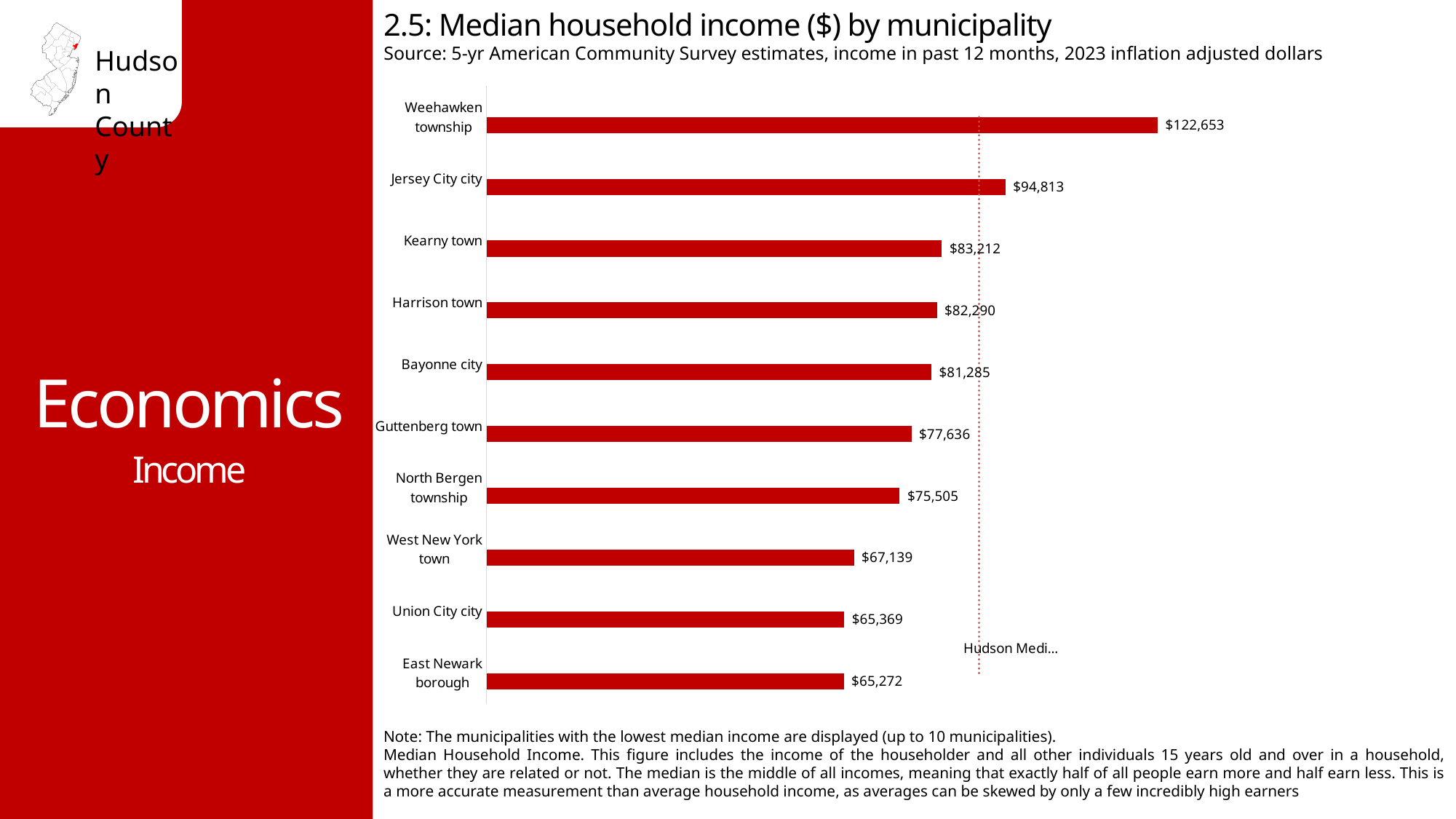
What is the difference in median household income between Union City city and East Newark borough? $97 Which has a higher median household income, Bayonne city or Guttenberg town? Bayonne city Which municipality has the lowest median household income on the chart? East Newark borough How many municipalities are shown on the chart? 10 Which municipality has the highest median household income on the chart? Weehawken township What is the median household income for East Newark borough? $65,272 What is the median household income for Weehawken township? $122,653 What is the median household income for Jersey City city? $94,813 What is the difference in median household income between Weehawken township and Jersey City city? $27,840 What type of chart is used to show median household income by municipality? Bar chart What is the median household income for Guttenberg town? $77,636 What is the title of the chart? 2.5: Median household income ($) by municipality